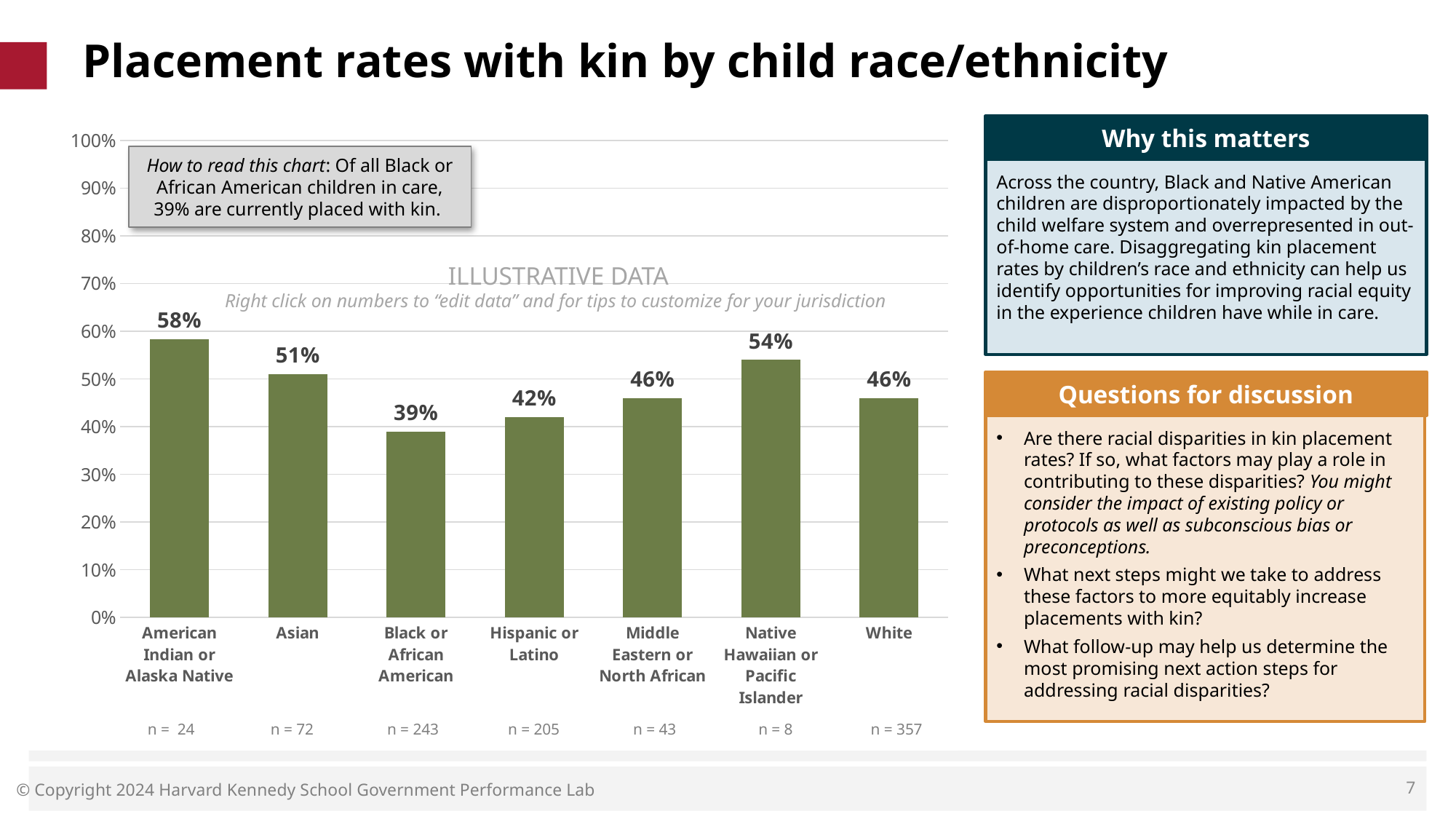
What kind of chart is shown on the slide? Bar chart How many race/ethnicity categories are shown on the chart? 7 What is the difference in placement rate with kin between American Indian or Alaska Native children and Black or African American children? 19 percentage points Which has a higher placement rate with kin: Hispanic or Latino children or White children? White What is the maximum value shown on the chart's vertical axis? 100% What is the placement rate with kin for Asian children? 51% What is the placement rate with kin for Black or African American children? 39% Is the placement rate with kin for Middle Eastern or North African children greater or less than 50%? less Which race/ethnicity category has the highest placement rate with kin? American Indian or Alaska Native What is the placement rate with kin for Native Hawaiian or Pacific Islander children? 54% What is the sample size (n) shown for White children? n = 357 Which race/ethnicity category has the lowest placement rate with kin? Black or African American